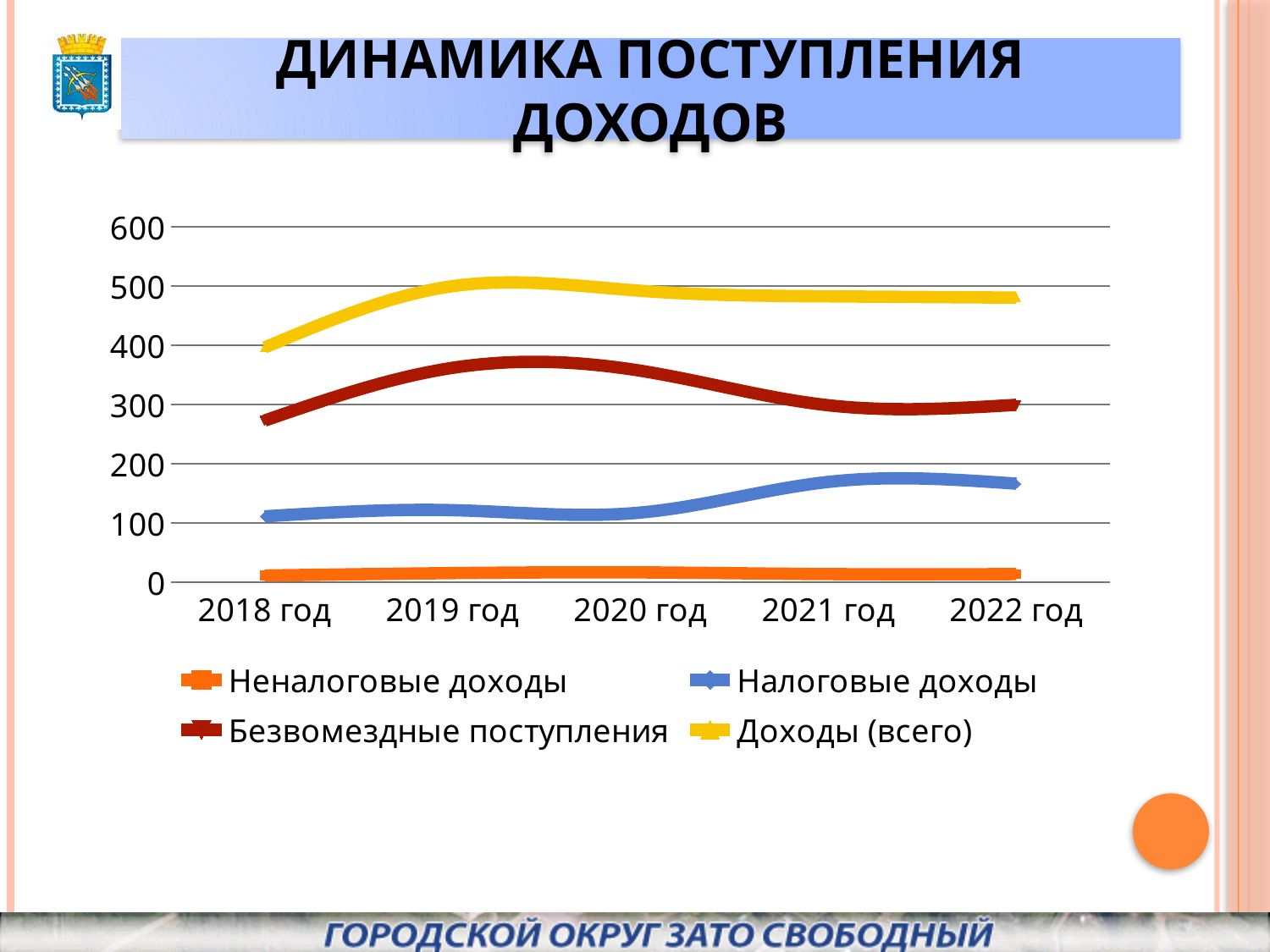
Which series is drawn in yellow? Доходы (всего) What is the title of the chart on the slide? ДИНАМИКА ПОСТУПЛЕНИЯ ДОХОДОВ Is the value for Безвозмездные поступления in 2018 год greater or less than 300? less In 2020 год, which is larger: Безвозмездные поступления or Налоговые доходы? Безвозмездные поступления How many years are plotted along the x axis? 5 In which year is Доходы (всего) at its highest? 2019 год How many series does the legend list? 4 Is the value for Доходы (всего) in 2022 год greater or less than 500? less Is the value for Неналоговые доходы in 2020 год greater or less than 100? less What kind of chart is shown on the slide? line chart Does Налоговые доходы rise or fall from 2020 год to 2021 год? rise